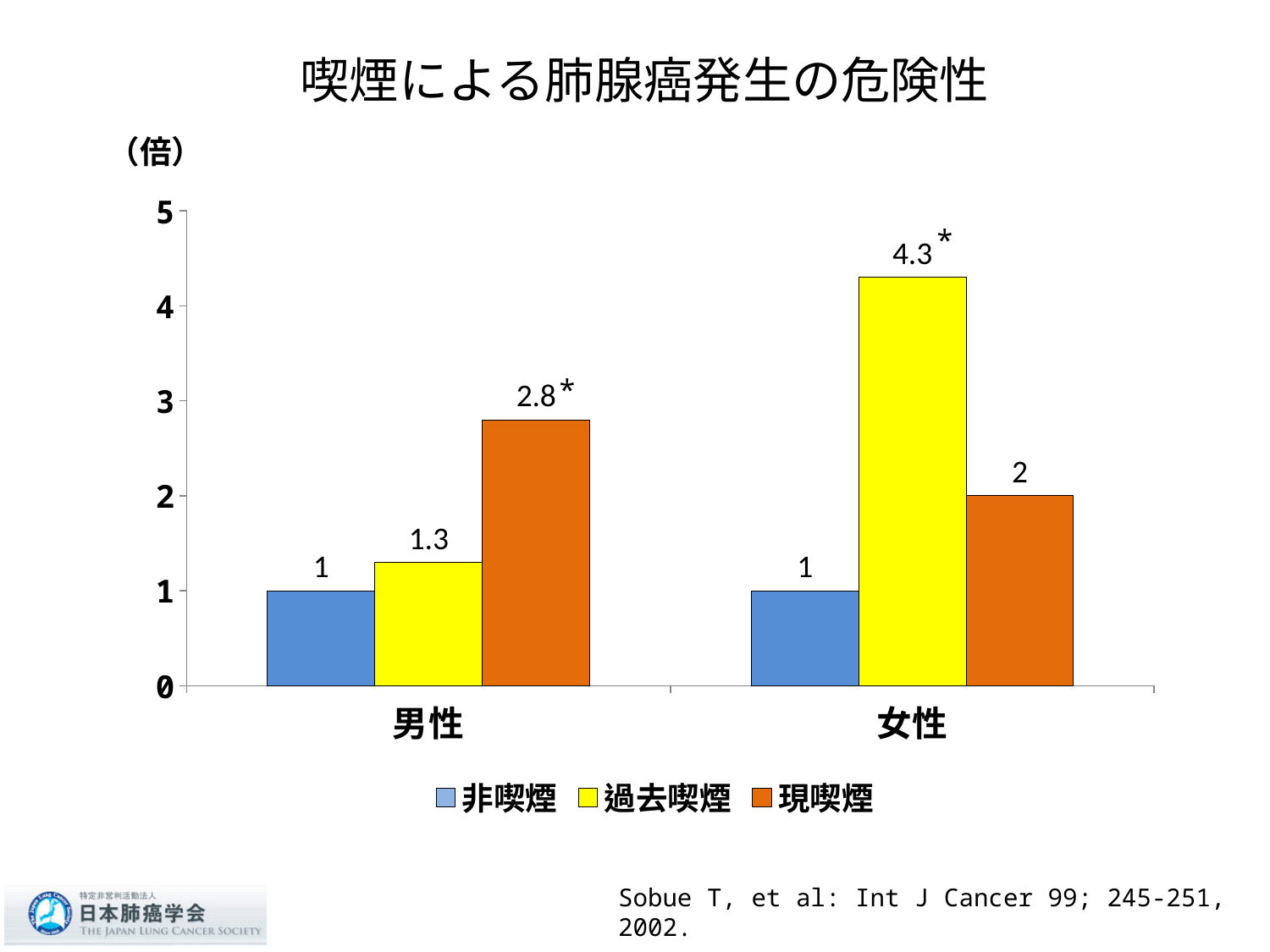
What is the difference between the 現喫煙 value and the 非喫煙 value in the 男性 group? 1.8 What kind of chart is shown on the slide? bar chart Which series has the highest value in the 女性 group? 過去喫煙 What is the value for 過去喫煙 in the 男性 group? 1.3 Which is larger: the 現喫煙 value for 男性 or the 現喫煙 value for 女性? 男性 What is the value for 現喫煙 in the 男性 group? 2.8 What is the value for 過去喫煙 in the 女性 group? 4.3 How many series does the legend list? 3 How many categories are shown on the x axis? 2 What is the difference between the 過去喫煙 value for 女性 and the 過去喫煙 value for 男性? 3 Which series has the lowest value in the 男性 group? 非喫煙 What is the value for 現喫煙 in the 女性 group? 2